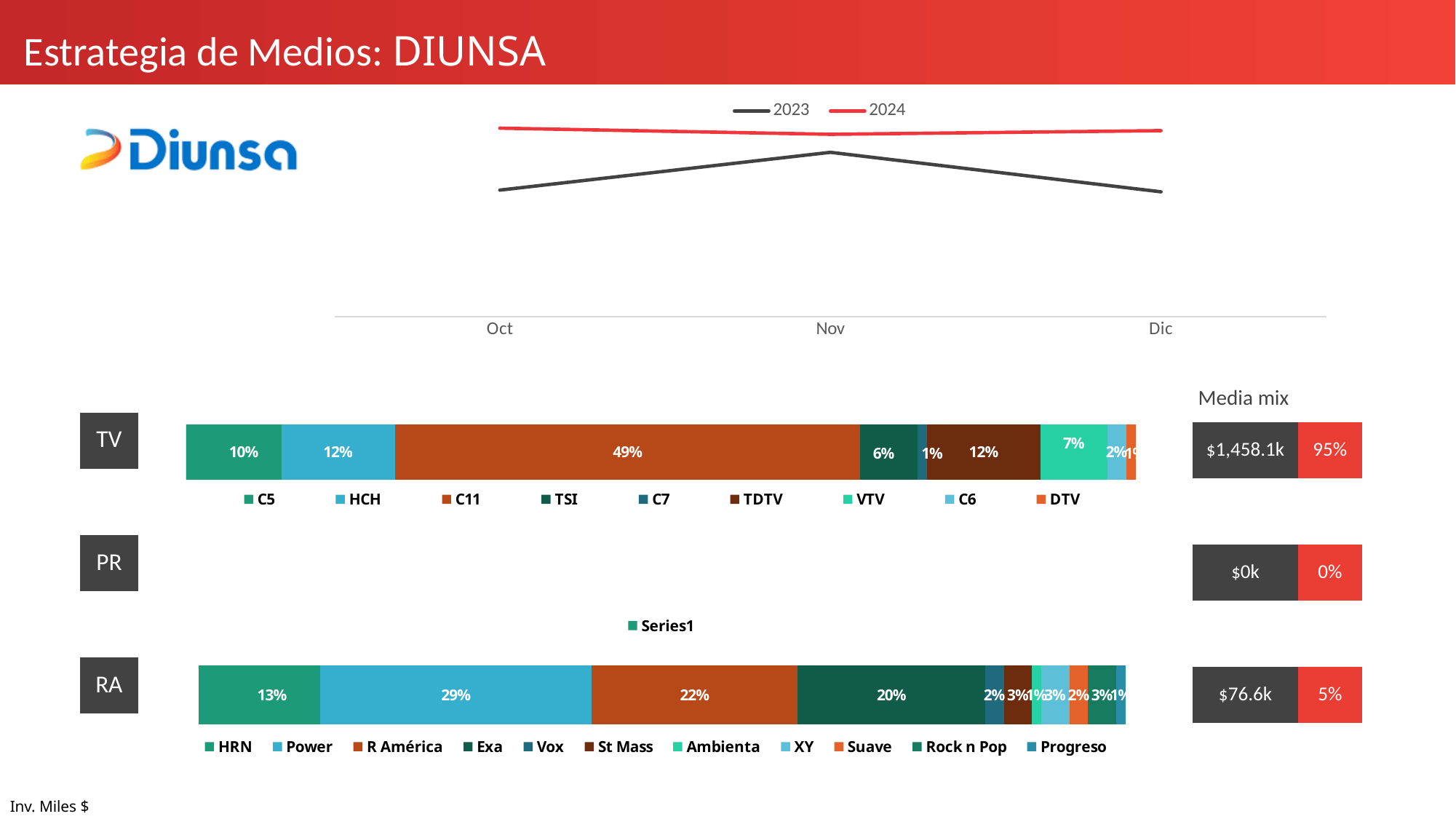
In the TV stacked bar chart, what is the difference between the HCH share and the C5 share? 2% In the TV stacked bar chart, which channel has the largest share? C11 In the line chart at the top of the slide, which series is higher in Oct, 2023 or 2024? 2024 In the RA stacked bar chart, what share does Power have? 29% How many entries does the legend of the RA stacked bar chart list? 11 In the line chart at the top of the slide, how many months are shown on the x axis? 3 In the RA stacked bar chart, which is larger, the share for R América or the share for Exa? R América In the RA stacked bar chart, which station has the largest share? Power In the TV stacked bar chart, what share does C11 have? 49% In the line chart at the top of the slide, does the 2023 line rise or fall from Nov to Dic? Fall How many entries does the legend of the TV stacked bar chart list? 9 What kind of chart is the chart at the top of the slide comparing 2023 and 2024? Line chart